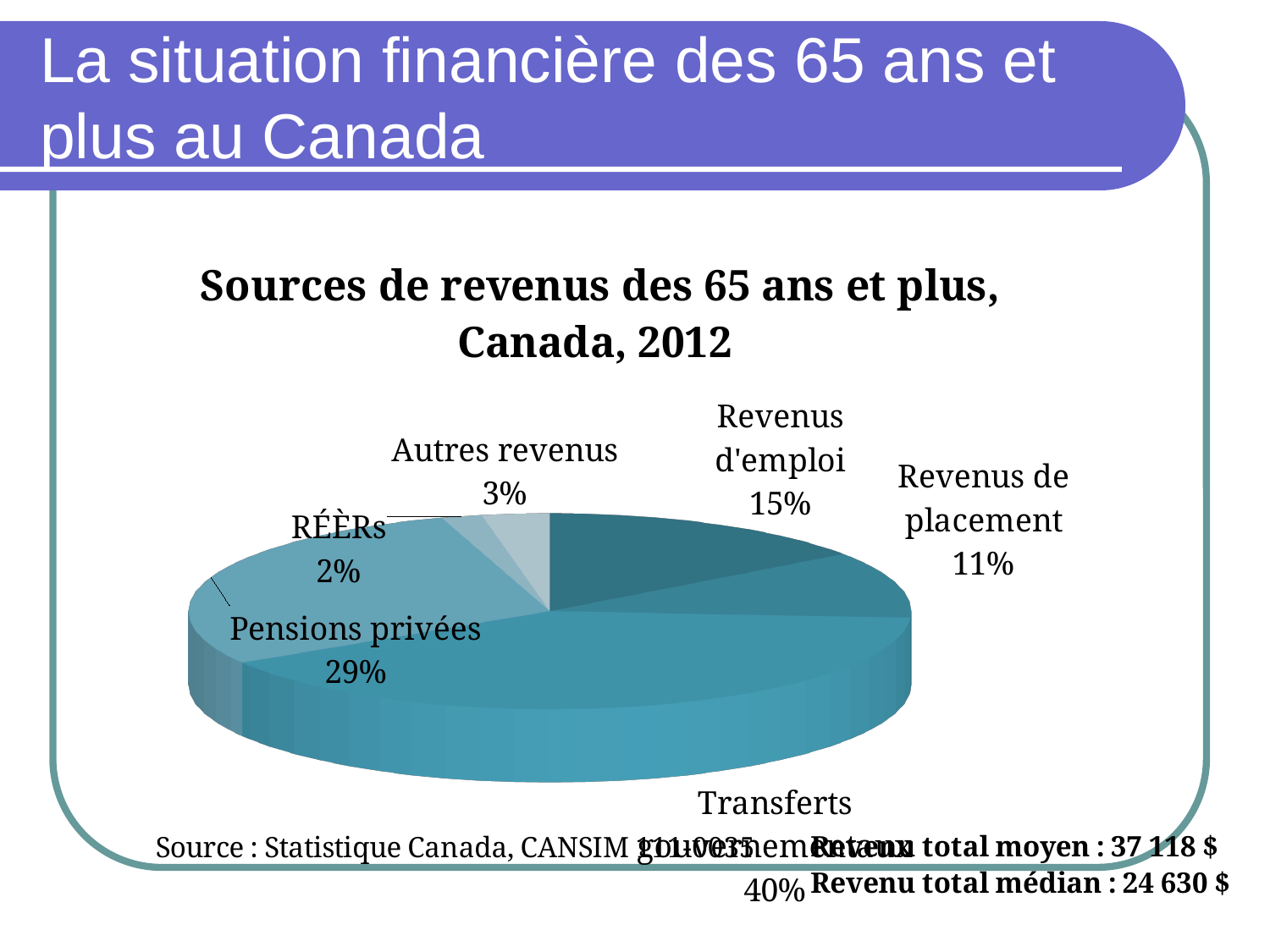
What kind of chart is shown on the slide? pie chart What percentage is shown for Revenus de placement? 11% How many slices does the pie chart have? 6 What is the title of the pie chart? Sources de revenus des 65 ans et plus, Canada, 2012 Which is larger, Revenus d'emploi or Revenus de placement? Revenus d'emploi What percentage is shown for Revenus d'emploi? 15% What percentage is shown for RÉÈRs? 2% What share of income do Pensions privées represent in the pie chart? 29% Which income source has the smallest slice of the pie? RÉÈRs What is the difference in percentage points between Pensions privées and Revenus d'emploi? 14 Which income source has the largest slice of the pie? Transferts gouvernementaux What percentage is shown for Autres revenus? 3%